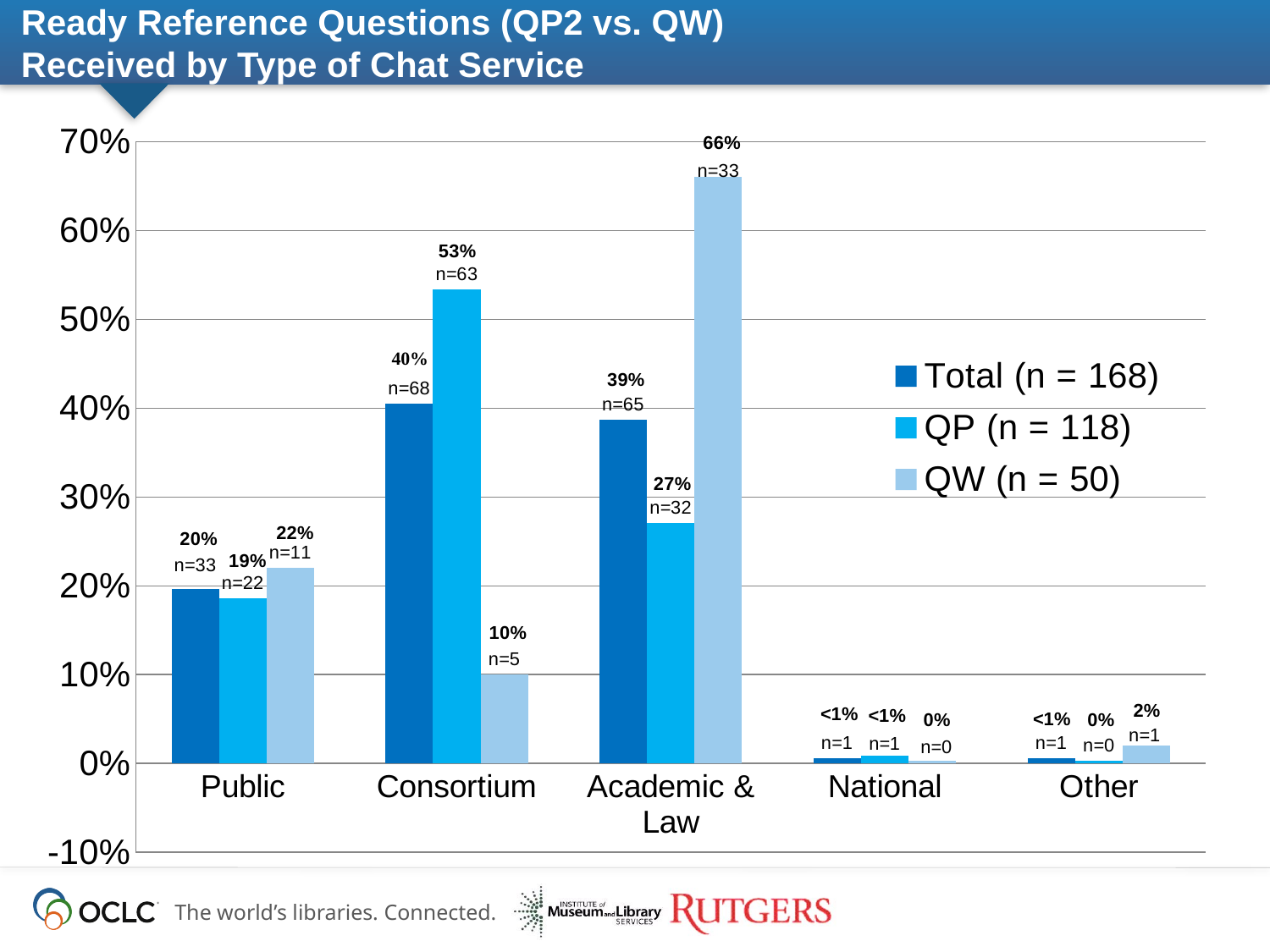
What is the QW value for Consortium? 10% What is the sample size (n) shown in the legend for the QW series? n = 50 Which category has the highest QP value? Consortium What is the Total value for Public? 20% What kind of chart is shown on the slide? Bar chart What is the QP value for Consortium? 53% How many categories are shown on the x axis? 5 Which category has the lowest QW value? National Which is larger for Consortium, the Total value or the QP value? QP What is the QW value for Academic & Law? 66% What is the difference between the QW and QP values for Academic & Law? 39% How many series does the legend list? 3